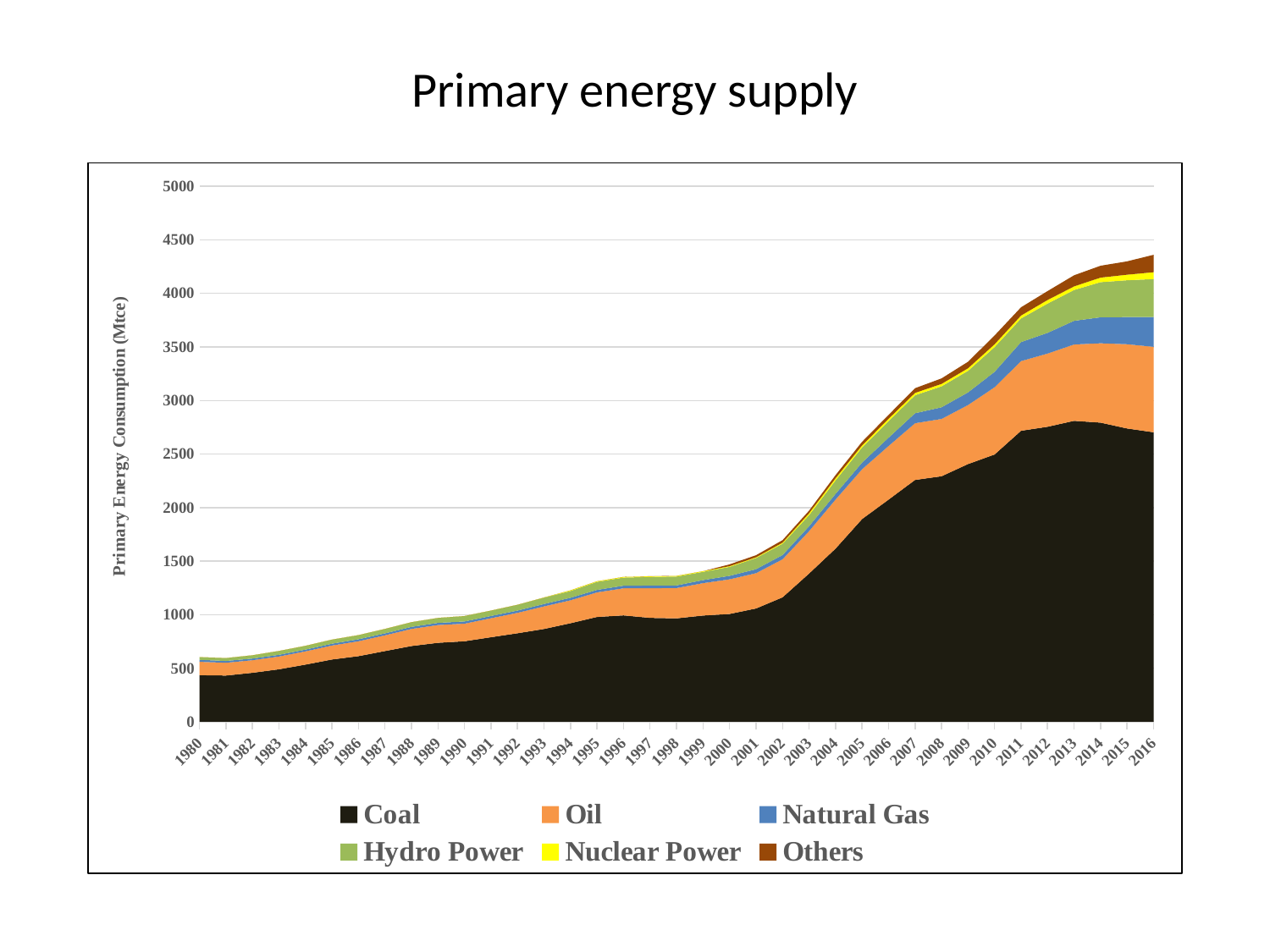
Is the total primary energy consumption in 2016 greater or less than 4000? greater Does total primary energy consumption generally rise or fall from 1980 to 2016? Rise How many years are plotted along the x axis? 37 Which year has the highest total primary energy consumption? 2016 What is the label of the y axis? Primary Energy Consumption (Mtce) Which year has the lowest total primary energy consumption? 1981 Is the value for Coal in 2016 greater or less than 2500? greater Which energy source contributes the largest share of primary energy consumption in 2016? Coal What kind of chart is shown on the slide? Stacked area chart How many series does the legend list? 6 Is the total primary energy consumption in 1980 greater or less than 1000? less What is the title of the chart? Primary energy supply